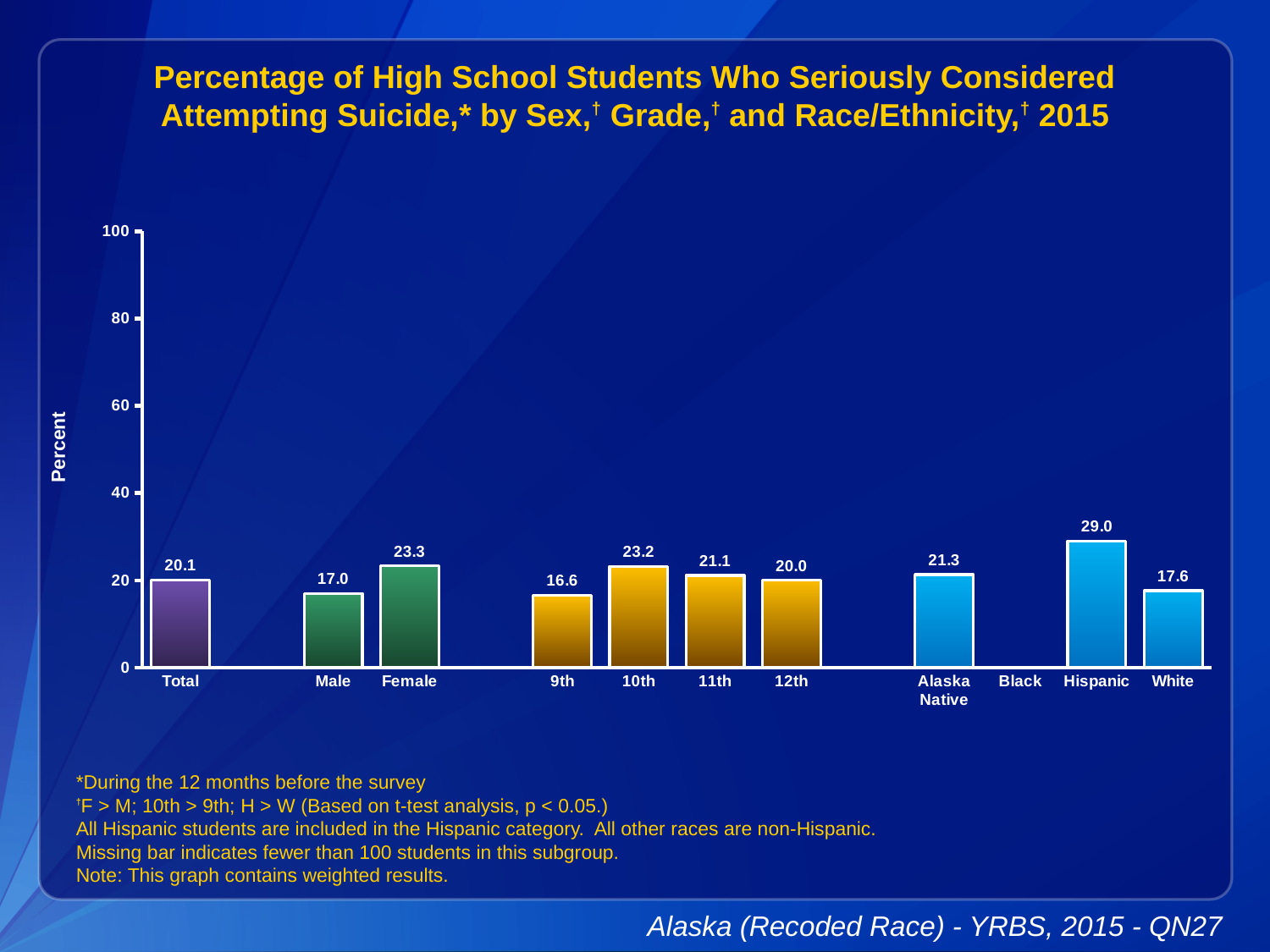
What kind of chart is shown? bar chart Which category has the highest value? Hispanic What is the value for Total? 20.1 What is the value for 9th grade? 16.6 What is the value for Female? 23.3 Which category label has no bar shown? Black Which is larger, the value for 10th grade or 12th grade? 10th What is the value for Hispanic? 29.0 What is the difference between the Female and Male values? 6.3 Which category has the lowest value among the bars shown? 9th How many bars are plotted on the chart? 11 Is the value for Alaska Native greater or less than 40? less